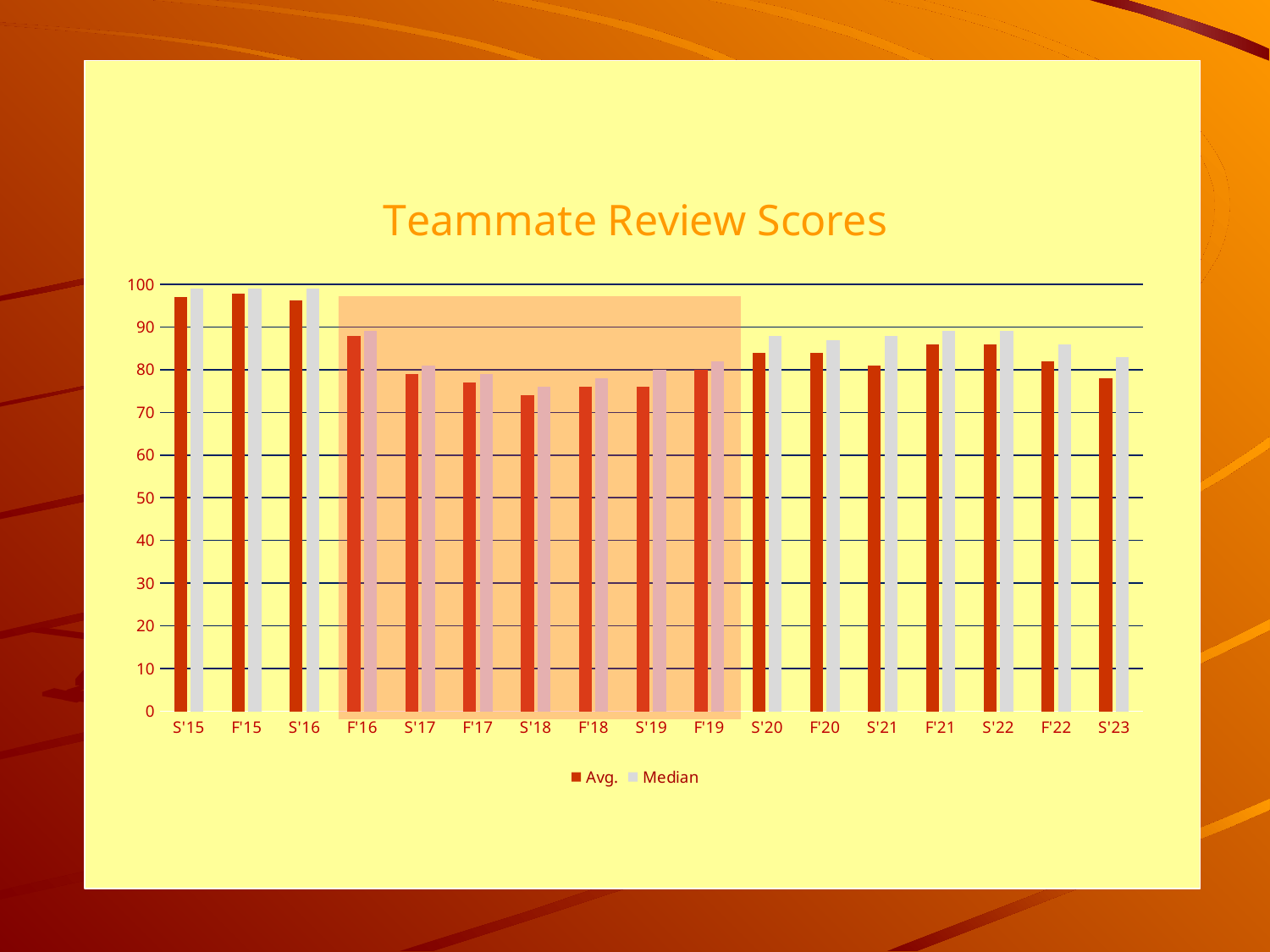
Is the Avg. value for S'15 greater or less than 90? greater How many semesters (categories) are shown on the x axis? 17 What is the title of the chart? Teammate Review Scores Which semester has the lowest Avg. score? S'18 What kind of chart is shown on the slide? bar chart What are the two series named in the legend? Avg. and Median How many series does the legend list? 2 Is the Median value for S'20 greater or less than 80? greater Which is larger, the Avg. score for S'15 or the Avg. score for S'18? S'15 Which semester has the lowest Median score? S'18 Is the Avg. value for S'18 greater or less than 80? less Do the Avg. scores rise or fall from S'16 to S'18? fall